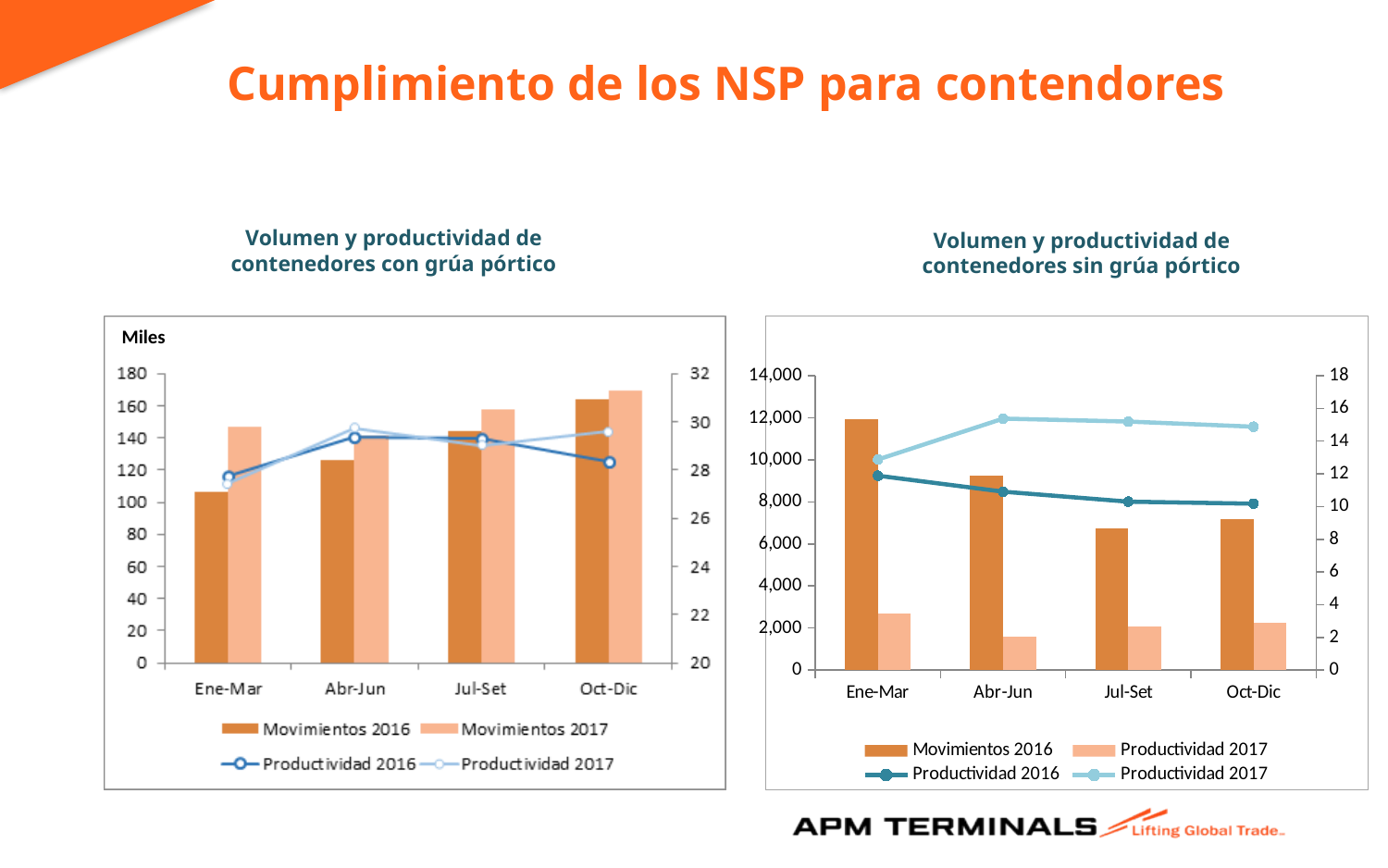
In the right chart (sin grúa pórtico), which quarter has the highest Movimientos 2016 bar? Ene-Mar In the left chart (con grúa pórtico), is the Movimientos 2016 value for Ene-Mar greater or less than 120? less In the left chart (con grúa pórtico), how many quarters are shown on the x axis? 4 What kind of chart is the left chart, 'Volumen y productividad de contenedores con grúa pórtico'? Combination bar and line chart In the left chart (con grúa pórtico), which is larger for Ene-Mar: Movimientos 2016 or Movimientos 2017? Movimientos 2017 In the left chart (con grúa pórtico), which quarter has the highest Movimientos 2016 bar? Oct-Dic In the right chart (sin grúa pórtico), does the Productividad 2016 line rise or fall from Ene-Mar to Oct-Dic? Fall In the left chart (con grúa pórtico), how many series does the legend list? 4 In the right chart (sin grúa pórtico), is the Movimientos 2016 value for Ene-Mar greater or less than 10,000? greater In the left chart (con grúa pórtico), do the Movimientos 2016 bars rise or fall from Ene-Mar to Oct-Dic? Rise What unit label is printed at the top of the left chart's vertical axis? Miles In the left chart (con grúa pórtico), is the Movimientos 2017 value for Oct-Dic greater or less than 160? greater